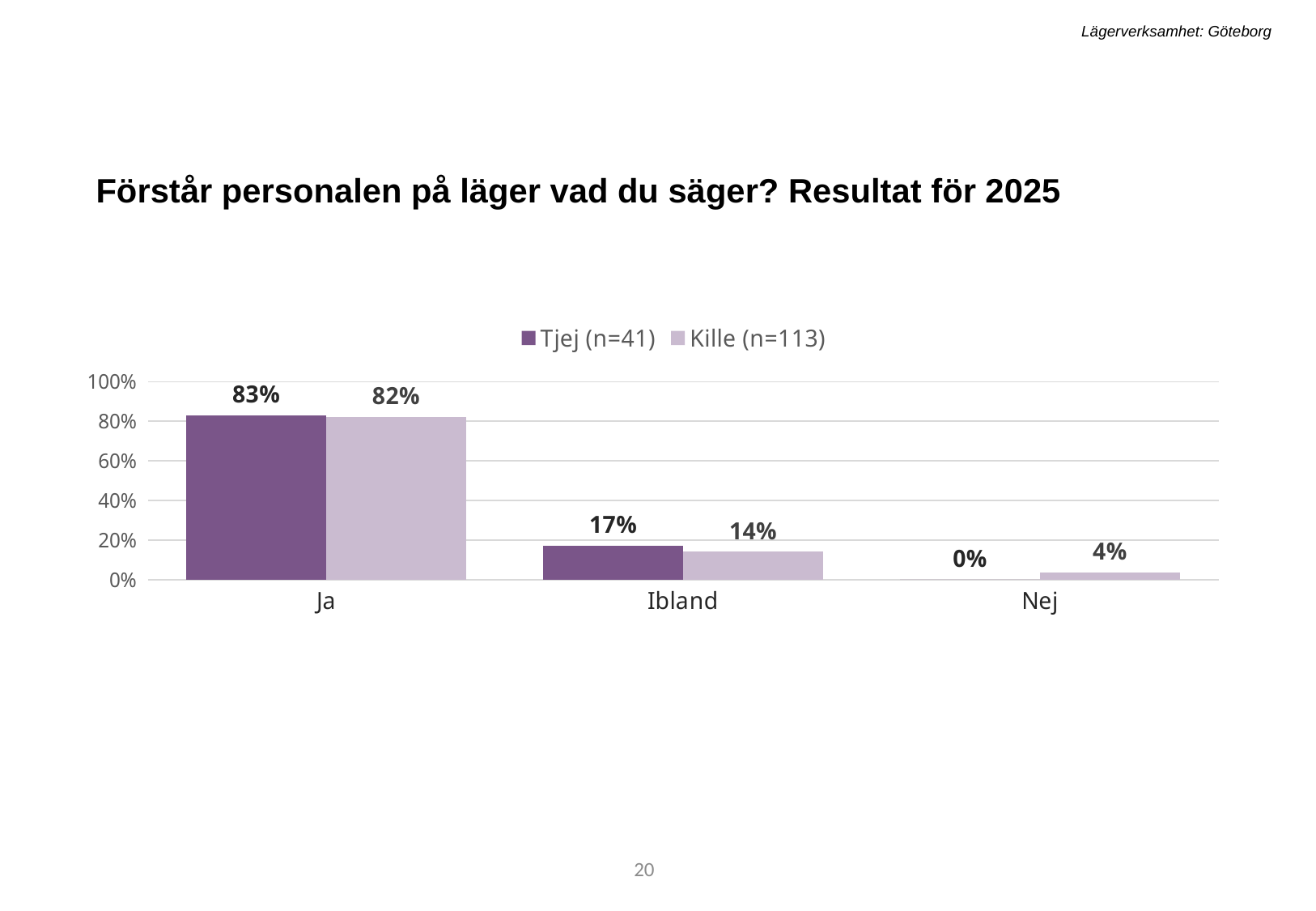
What is the title of the slide? Förstår personalen på läger vad du säger? Resultat för 2025 What is the difference between the Tjej (n=41) and Kille (n=113) values in the Ibland category? 3% What is the value for Kille (n=113) in the Ibland category? 14% How many series does the legend list? 2 Which category has the highest value for Kille (n=113)? Ja Which series has the larger value in the Nej category, Tjej (n=41) or Kille (n=113)? Kille (n=113) Which category has the lowest value for Tjej (n=41)? Nej What is the value for Tjej (n=41) in the Ja category? 83% How many categories are shown on the x axis? 3 What is the value for Tjej (n=41) in the Nej category? 0% What is the value for Kille (n=113) in the Nej category? 4% What kind of chart is shown on the slide? Bar chart